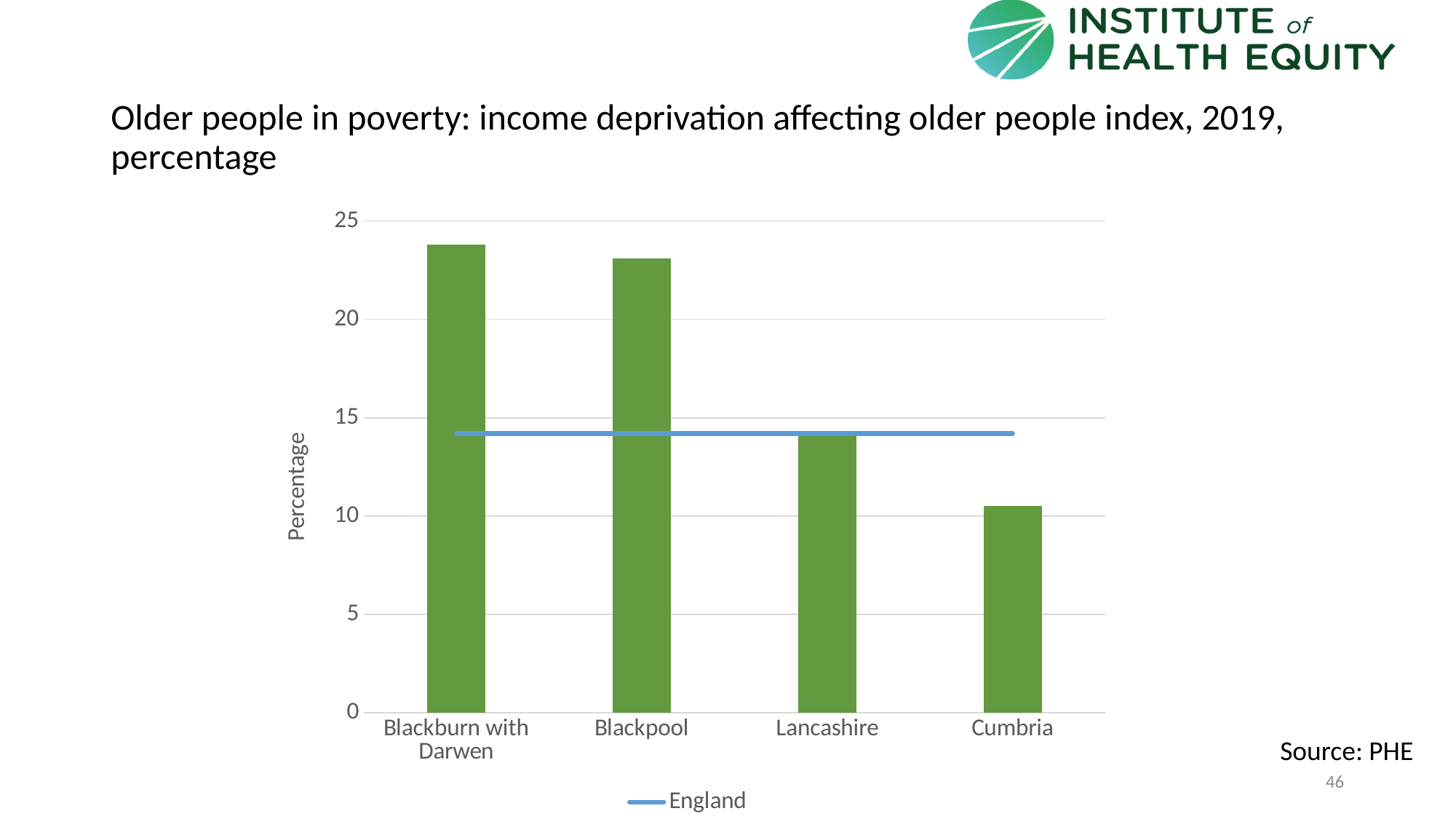
What is the label on the vertical axis of the chart? Percentage Is the value for Blackpool greater or less than 20? greater Do the bar values rise or fall from left to right across the x axis? fall How many areas are shown on the x axis of the chart? 4 Is the value for Blackburn with Darwen greater or less than 20? greater Is the value for Cumbria greater or less than 15? less Which area has the highest percentage in the chart? Blackburn with Darwen What kind of chart is shown on the slide? bar chart What does the horizontal blue line in the chart represent, according to the legend? England Which area has the lowest percentage in the chart? Cumbria Which is larger, the value for Blackpool or the value for Cumbria? Blackpool